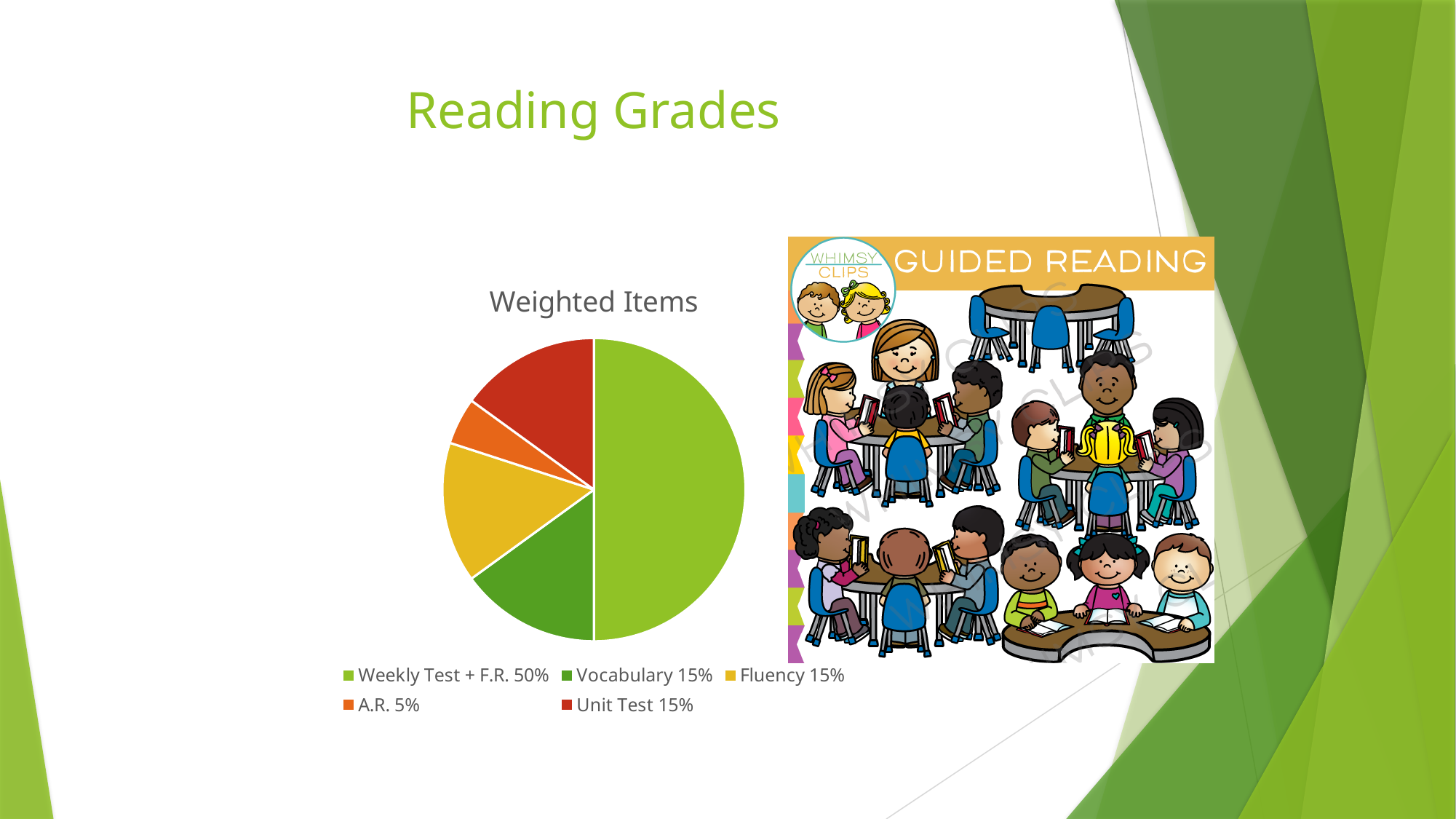
What percentage is shown for Weekly Test + F.R. in the Weighted Items chart? 50% What is the title of the chart on the slide? Weighted Items What percentage is shown for A.R. in the Weighted Items chart? 5% Which item has the smallest share of the Weighted Items pie chart? A.R. What colour is the Weekly Test + F.R. slice in the Weighted Items chart? light green How many slices does the Weighted Items pie chart have? 5 What type of chart is shown under the title "Weighted Items"? pie chart What share of the Weighted Items pie does Vocabulary represent? 15% Which is larger in the Weighted Items chart, Fluency or A.R.? Fluency What is the difference between the Weekly Test + F.R. share and the A.R. share? 45% Which item has the largest share of the Weighted Items pie chart? Weekly Test + F.R. What percentage is shown for Unit Test in the Weighted Items chart? 15%